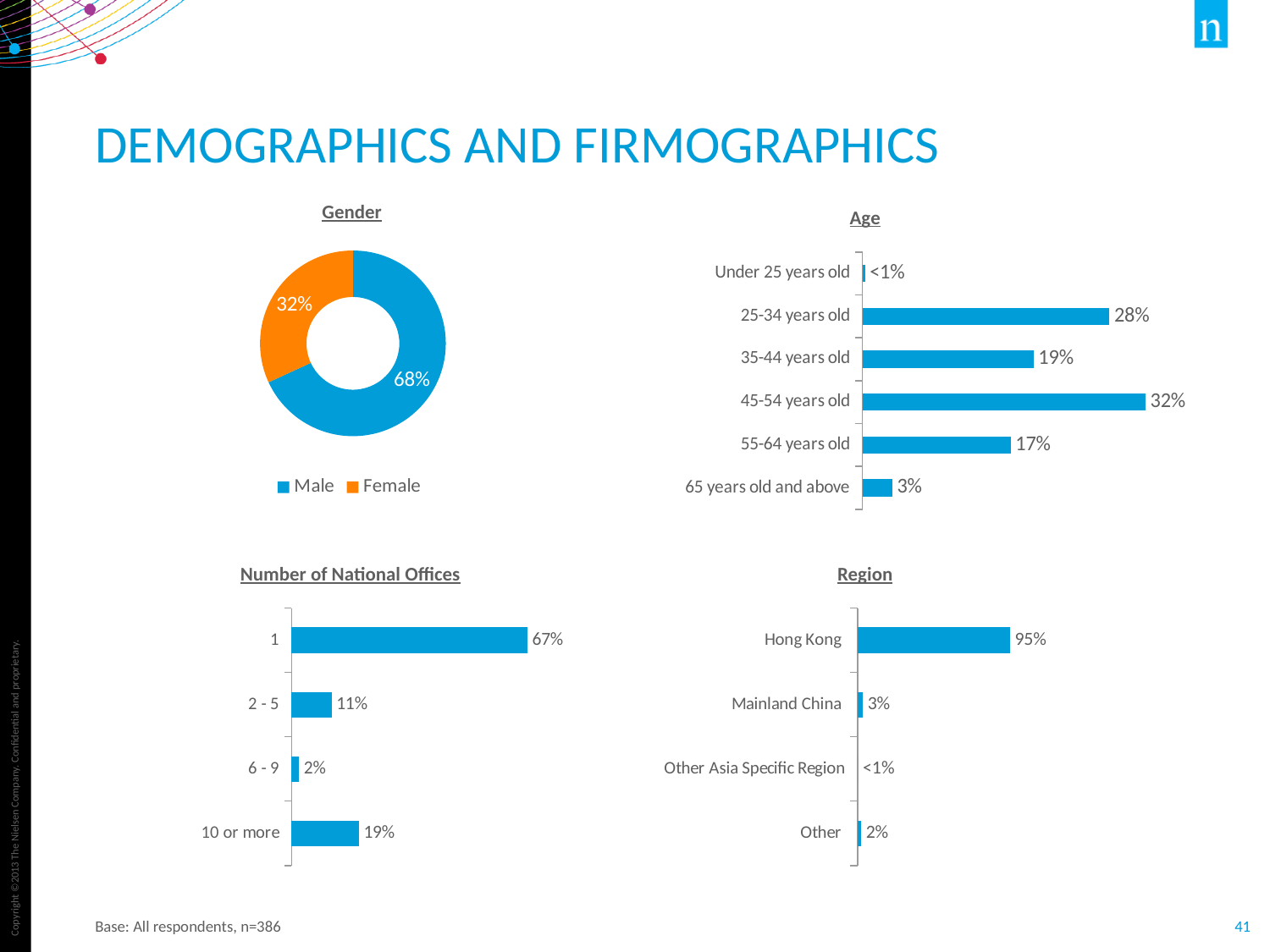
What kind of chart is the Gender chart? Doughnut chart In the Gender chart, what share of respondents are Male? 68% In the Number of National Offices chart, what is the value for 10 or more? 19% In the Region chart, what is the value for Hong Kong? 95% In the Gender chart, what share of respondents are Female? 32% How many age groups are shown in the Age chart? 6 In the Number of National Offices chart, which category is larger: 2 - 5 or 6 - 9? 2 - 5 In the Age chart, which age group has the lowest value? Under 25 years old What kind of chart is the Region chart? Bar chart In the Age chart, which age group has the highest value? 45-54 years old In the Age chart, what is the difference between 25-34 years old and 35-44 years old? 9% In the Age chart, what is the value for 45-54 years old? 32%